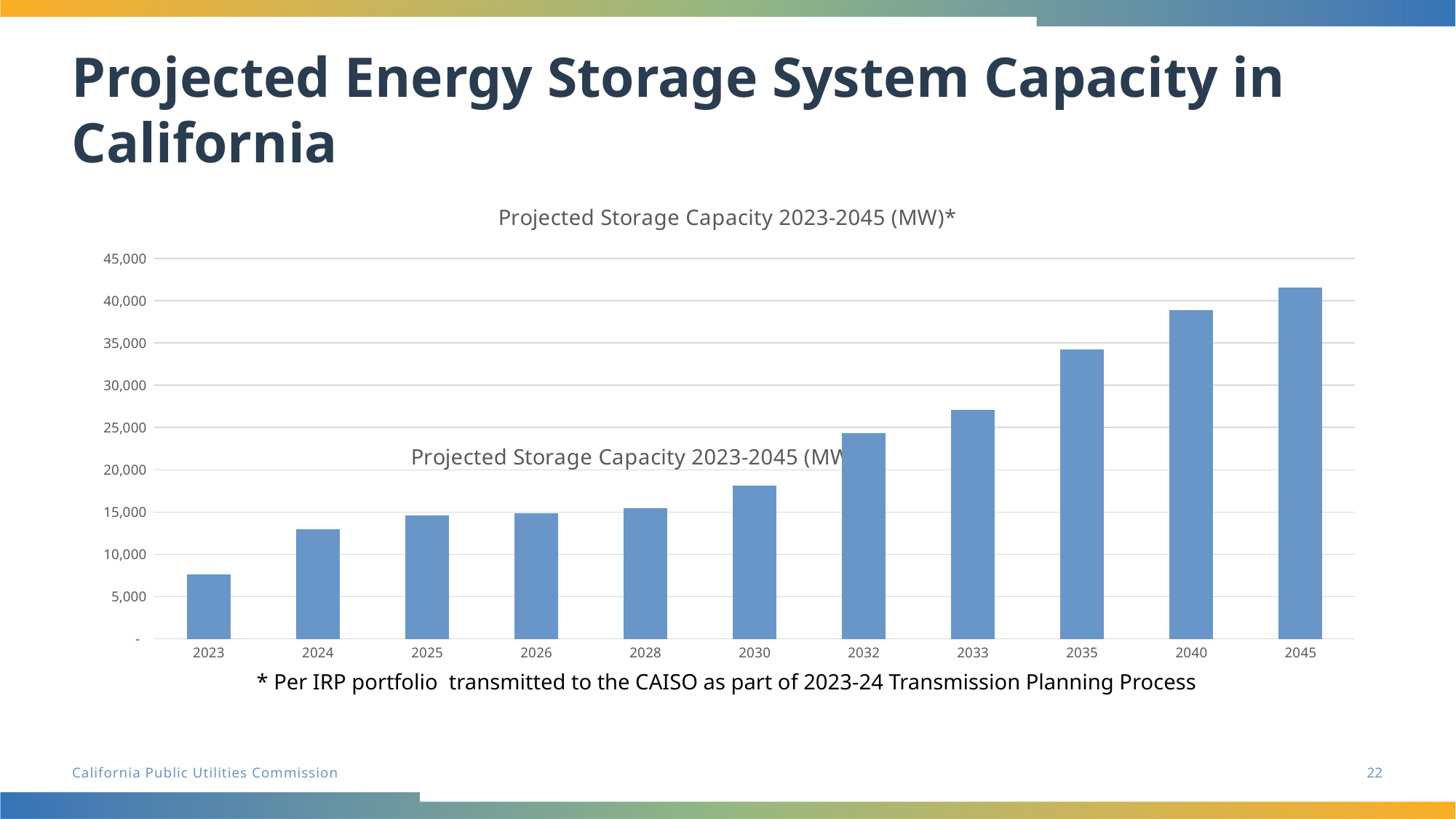
Is the value for 2045 greater or less than 40,000? greater Is the value for 2024 greater or less than 10,000? greater How many years are shown on the x axis of the chart? 11 Is the value for 2023 greater or less than 10,000? less What kind of chart is shown on the slide? Bar chart Which is larger, the value for 2035 or the value for 2030? 2035 Which year has the highest projected storage capacity? 2045 Which year has the lowest projected storage capacity? 2023 What is the title of the chart? Projected Storage Capacity 2023-2045 (MW)* Do the projected storage capacity values rise or fall from 2023 to 2045? Rise